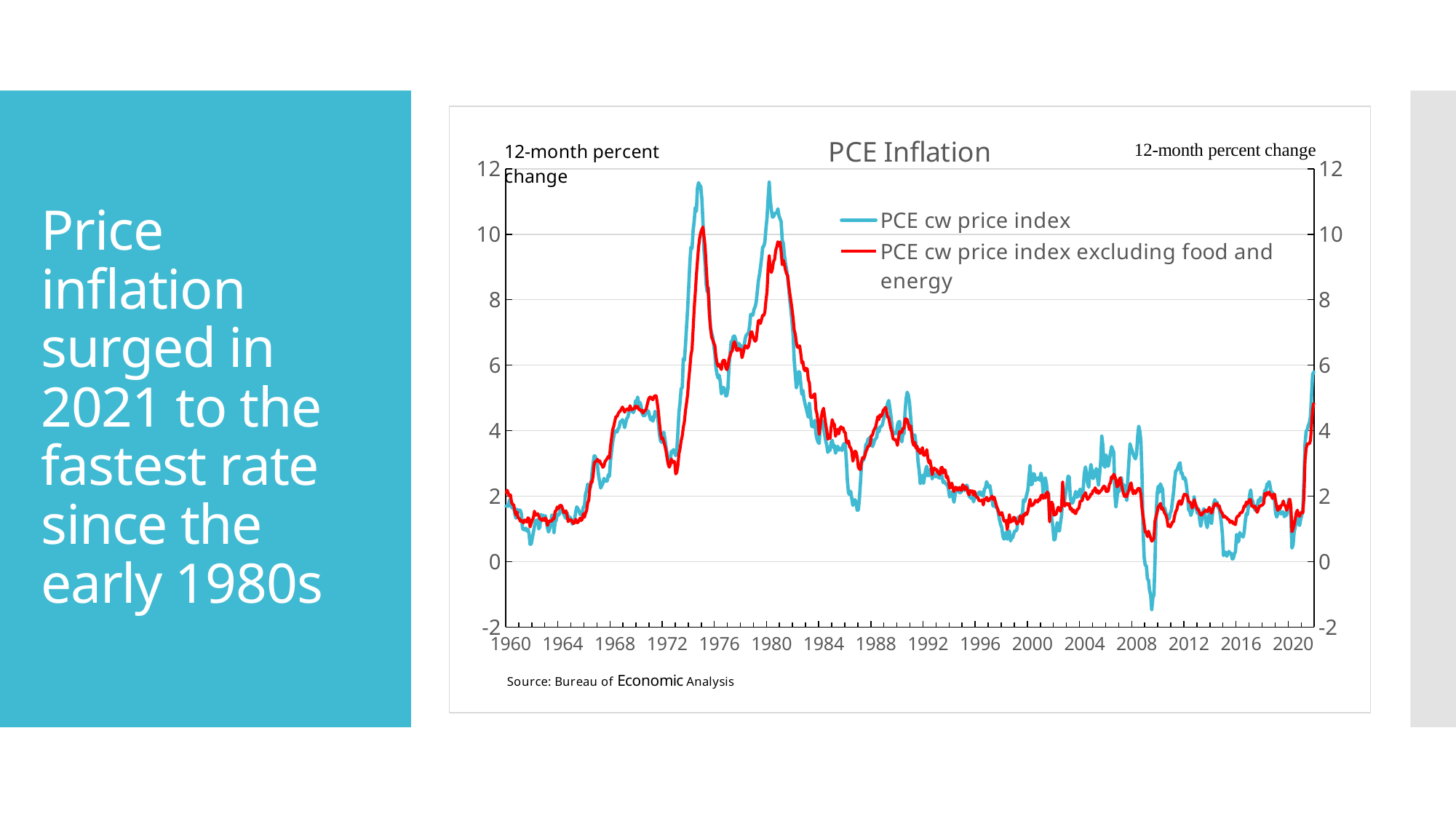
How many series does the legend of the PCE Inflation chart list? 2 Which series is drawn in red in the PCE Inflation chart? PCE cw price index excluding food and energy Is the value of the PCE cw price index excluding food and energy around 2009 greater or less than 0? greater Around 2009, which series is higher: PCE cw price index or PCE cw price index excluding food and energy? PCE cw price index excluding food and energy What is the title of the chart? PCE Inflation Is the peak value of the PCE cw price index around 1974-1975 greater or less than 10? greater Is the lowest value of the PCE cw price index around 2009 greater or less than 0? less Around the 1974-1975 peak, which series is higher: PCE cw price index or PCE cw price index excluding food and energy? PCE cw price index Between 2020 and the end of the series in 2021, does the PCE cw price index rise or fall? rise What kind of chart is shown on the slide? line chart Between 1980 and 1986, does the PCE cw price index generally rise or fall? fall